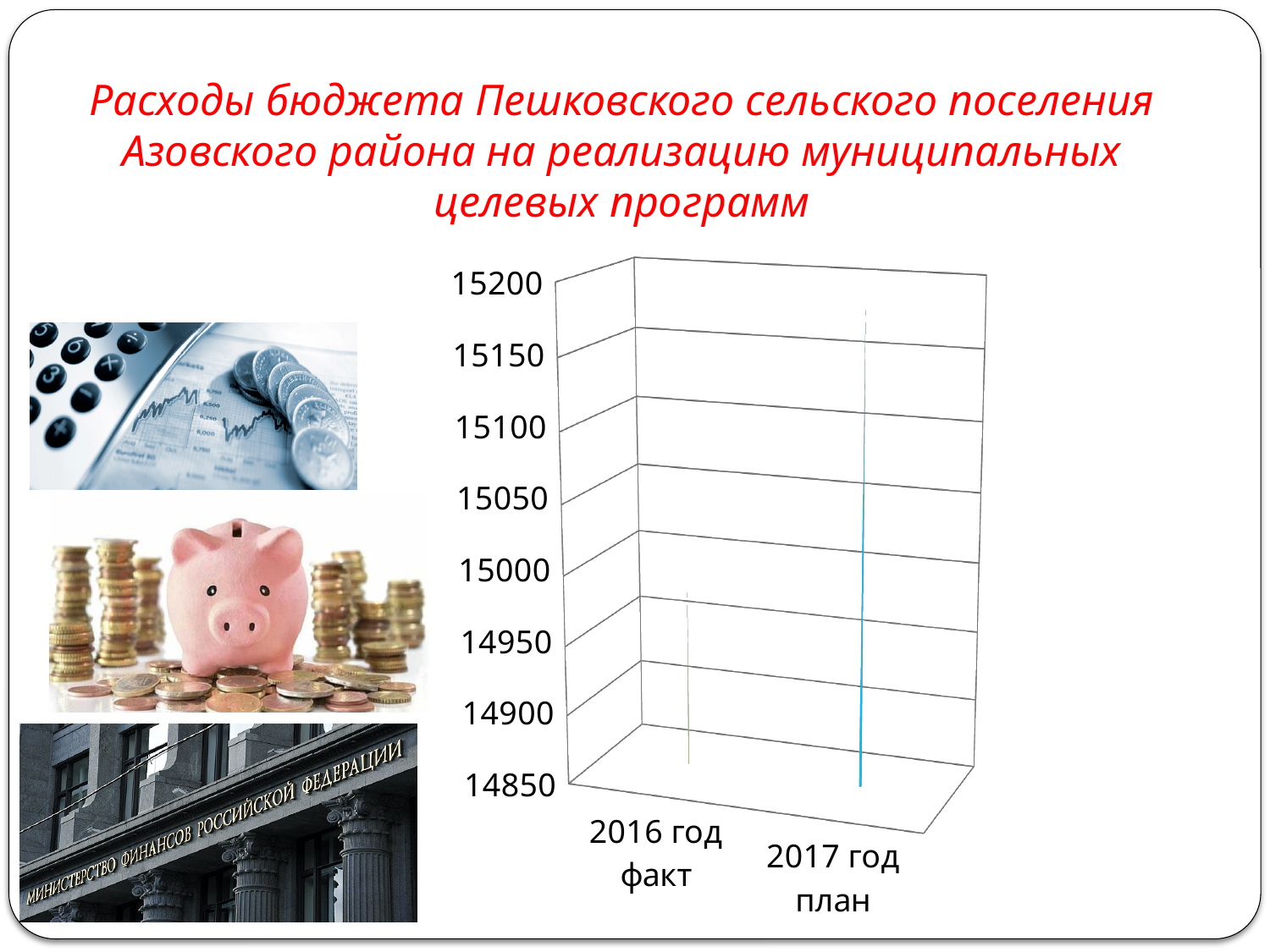
Is the value for 2017 год план greater or less than 15100? greater Is the value for 2016 год факт greater or less than 14900? greater Which is larger, the value for 2016 год факт or the value for 2017 год план? 2017 год план What kind of chart is shown on the slide? bar chart Which category has the lowest value on the chart? 2016 год факт How many categories are plotted on the chart? 2 What is the lowest value shown on the vertical axis of the chart? 14850 What is the highest value shown on the vertical axis of the chart? 15200 Which category has the highest value on the chart? 2017 год план Do the values rise or fall from 2016 год факт to 2017 год план? rise